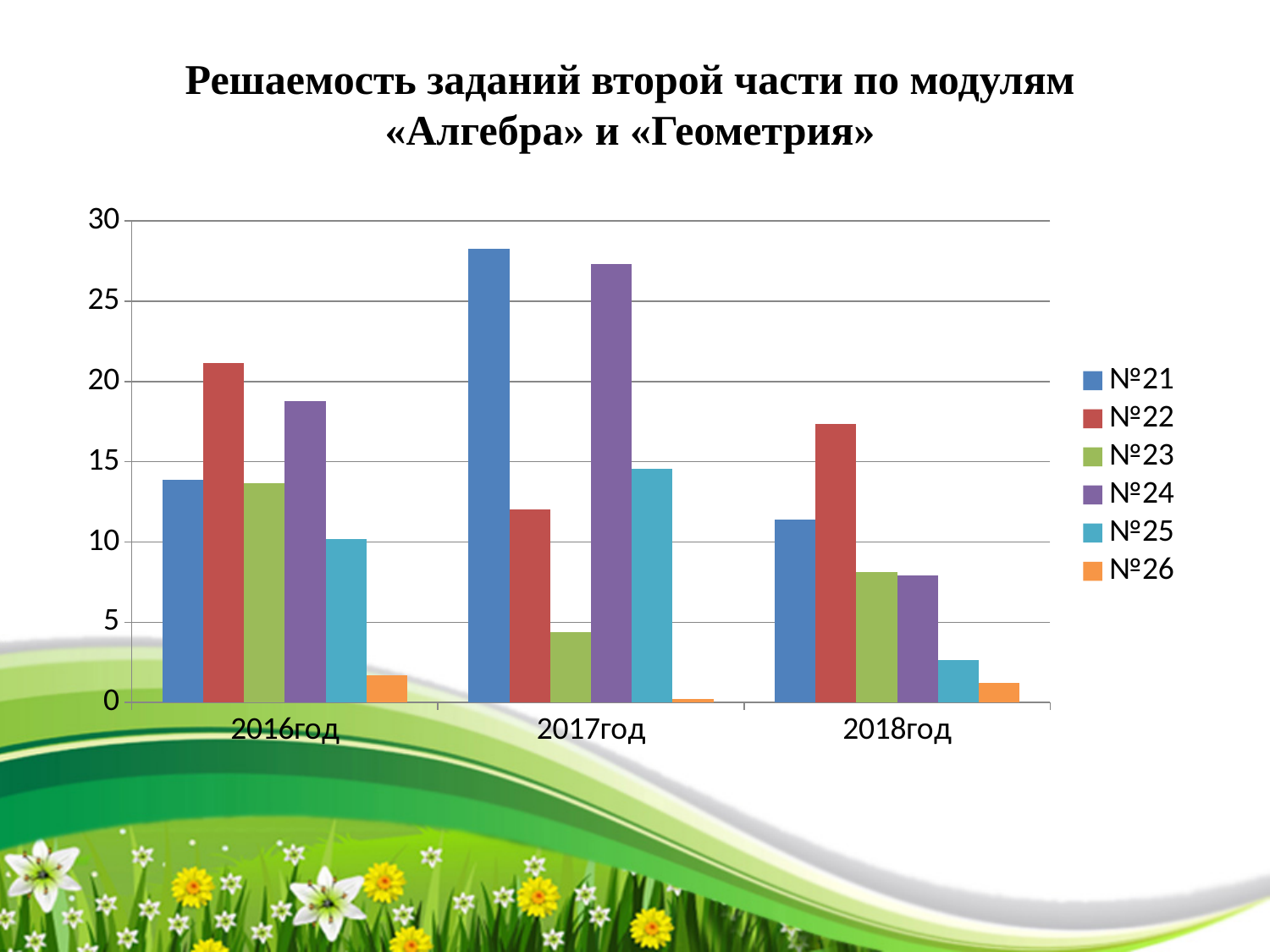
Which series has the lowest value in 2017год? №26 Is the value for №25 in 2018год greater or less than 5? less Which series is shown in orange in the legend? №26 Which series has the highest value in 2018год? №22 What kind of chart is shown on the slide? bar chart How many series does the legend list? 6 Is the value for №21 in 2017год greater or less than 25? greater Which is larger in 2016год: the value for №24 or the value for №25? №24 Does the value for №23 rise or fall from 2016год to 2017год? fall Is the value for №22 in 2016год greater or less than 20? greater How many year categories are shown on the x axis? 3